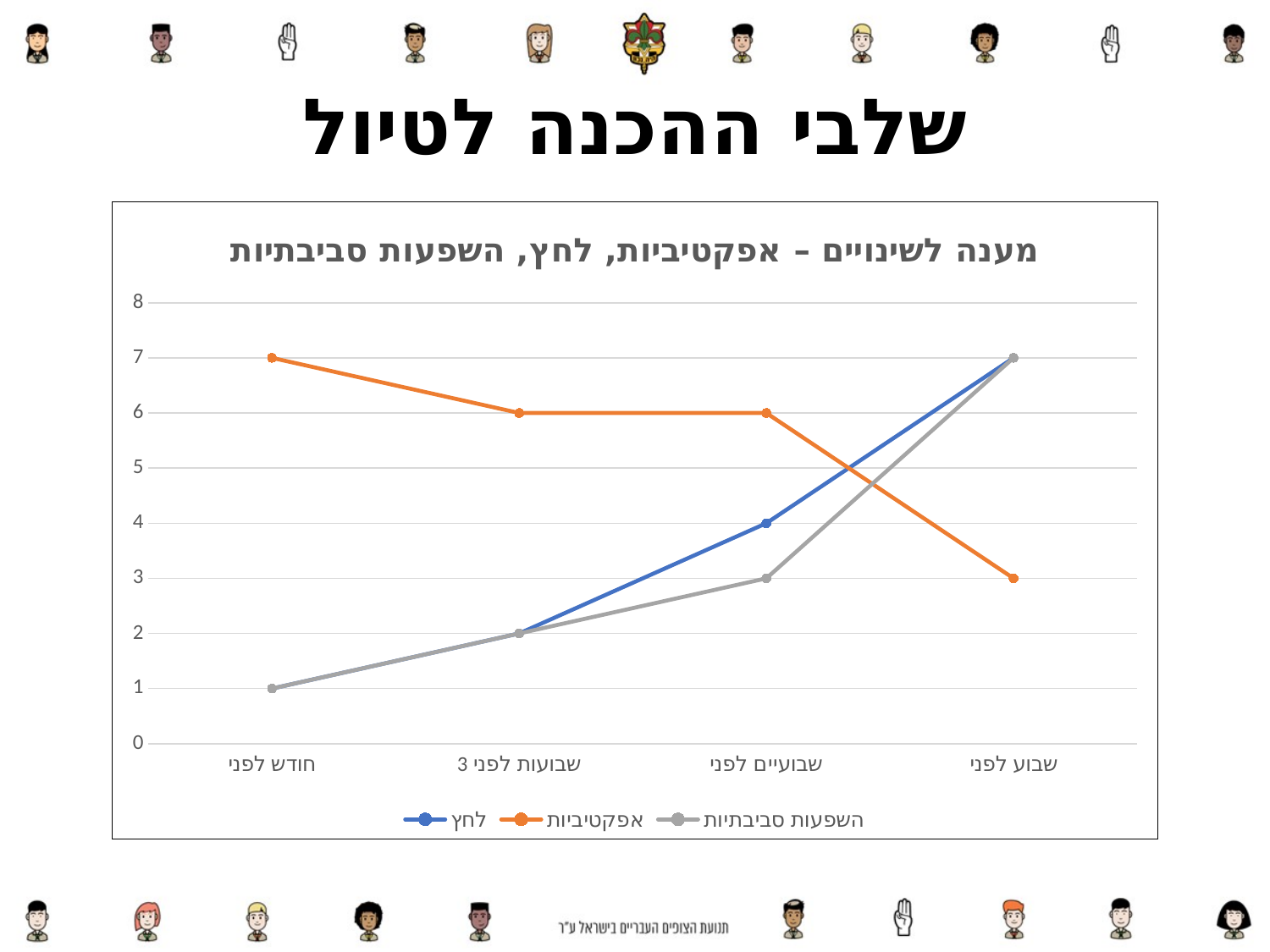
At which category is השפעות סביבתיות lowest? חודש לפני At שבועיים לפני, which is larger: אפקטיביות or לחץ? אפקטיביות What is the value of אפקטיביות at שבוע לפני? 3 What is the value of השפעות סביבתיות at שבועיים לפני? 3 Does the אפקטיביות series rise or fall from חודש לפני to שבוע לפני? fall How many categories are shown on the x axis? 4 What is the value of אפקטיביות at חודש לפני? 7 What is the value of לחץ at שבוע לפני? 7 How many series does the legend list? 3 What kind of chart is shown on the slide? line chart What is the difference between אפקטיביות at חודש לפני and at שבוע לפני? 4 What is the value of לחץ at שבועיים לפני? 4